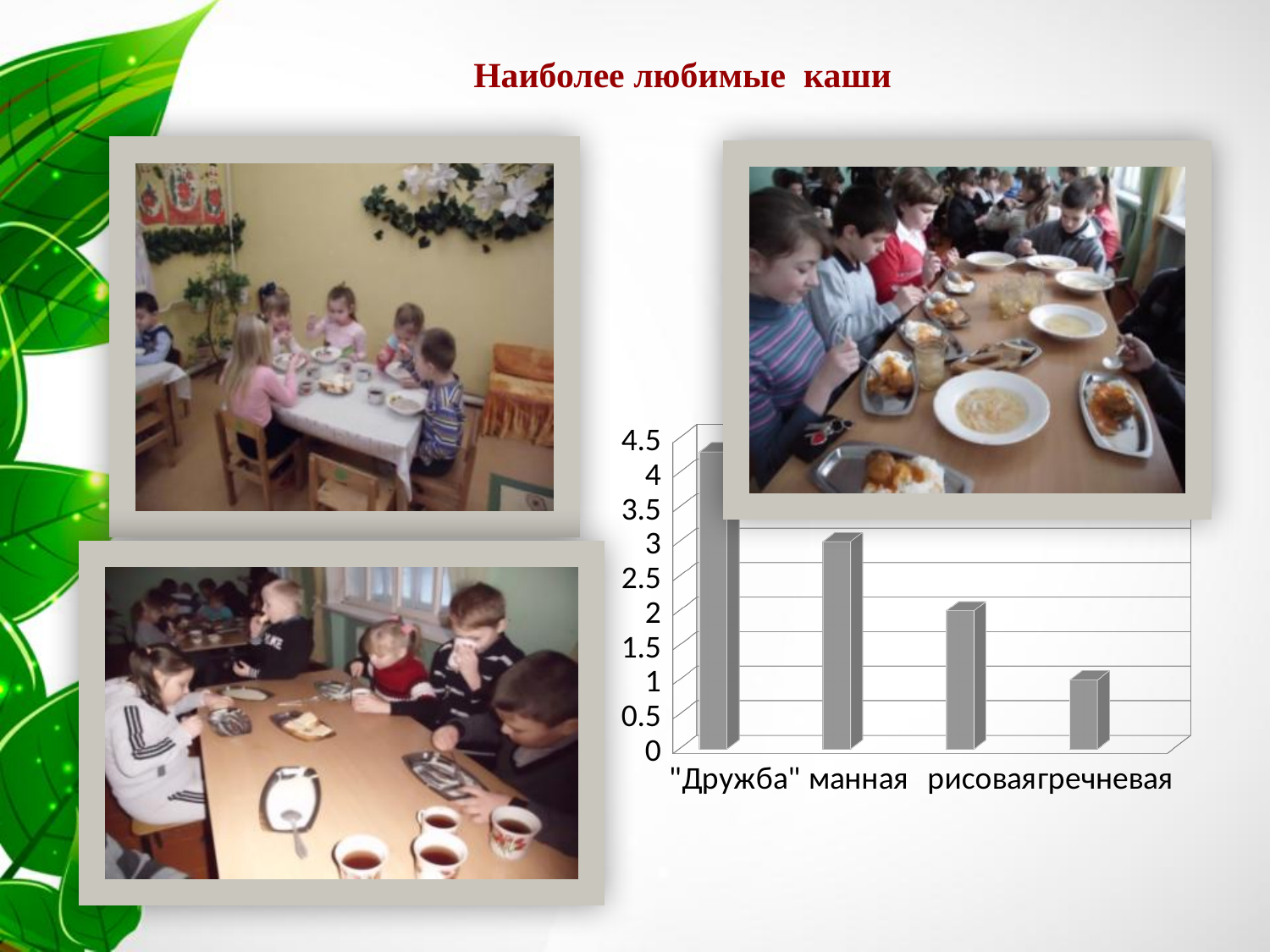
What is the highest tick value shown on the vertical axis of the chart? 4.5 Is the value for "Дружба" greater or less than 3.5? greater Is the value for гречневая greater or less than 1.5? less What kind of chart is shown on the slide? bar chart Which category has the highest bar in the chart? "Дружба" How many categories are shown on the x axis of the chart? 4 Is the value for рисовая greater or less than 2.5? less Which is larger, the value for манная or the value for рисовая? манная Which category has the lowest bar in the chart? гречневая Do the bar values rise or fall from left to right along the x axis? fall Which is larger, the value for гречневая or the value for "Дружба"? "Дружба"